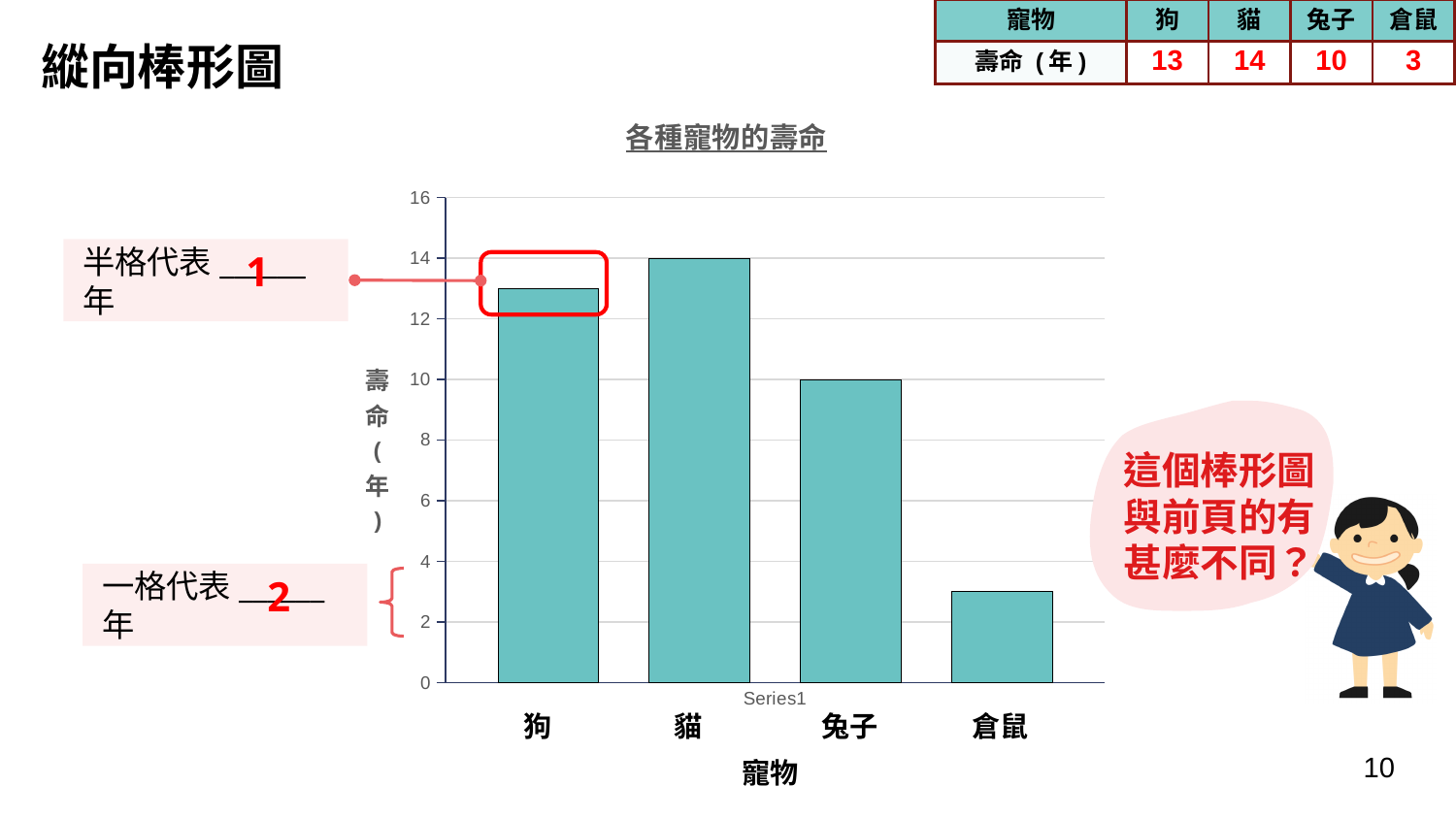
What is the lifespan value for 倉鼠 (hamster) in the chart 各種寵物的壽命? 3 What kind of chart is 各種寵物的壽命? bar chart Is the value for 兔子 in the chart 各種寵物的壽命 greater or less than 12? less What is the difference between the lifespan of 貓 and 倉鼠 in the chart 各種寵物的壽命? 11 Which pet has the highest bar in the chart 各種寵物的壽命? 貓 What is the label of the x axis of the chart 各種寵物的壽命? 寵物 What is the lifespan value for 兔子 (rabbit) in the chart 各種寵物的壽命? 10 What is the lifespan value for 狗 (dog) in the chart 各種寵物的壽命? 13 Which has a larger value in the chart 各種寵物的壽命, 狗 or 兔子? 狗 How many pet categories are shown on the x axis of the chart 各種寵物的壽命? 4 Which pet has the lowest bar in the chart 各種寵物的壽命? 倉鼠 What is the title of the chart on the slide? 各種寵物的壽命